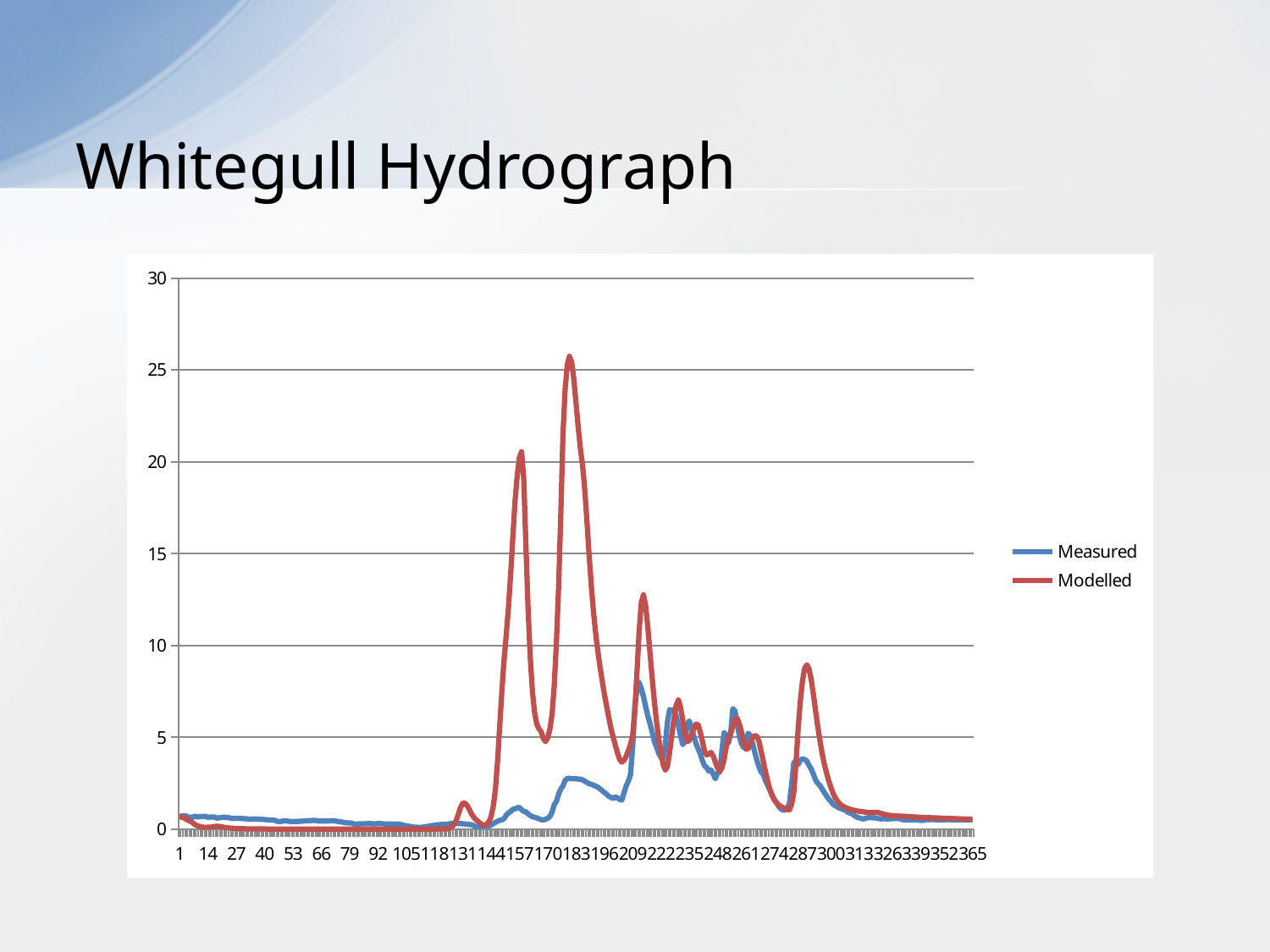
Which series reaches the highest peak on the chart? Modelled Is the Measured value at day 1 greater or less than 5? less Does either series ever exceed 30 on the chart? No Around day 157, is the Modelled value greater or less than 15? greater Around day 183, which series has the larger value, Measured or Modelled? Modelled Do the values of both series rise or fall between day 300 and day 365? fall What kind of chart is shown on the slide? line chart How many series does the legend list? 2 What are the two series named in the legend? Measured and Modelled What colour is the Modelled line? red